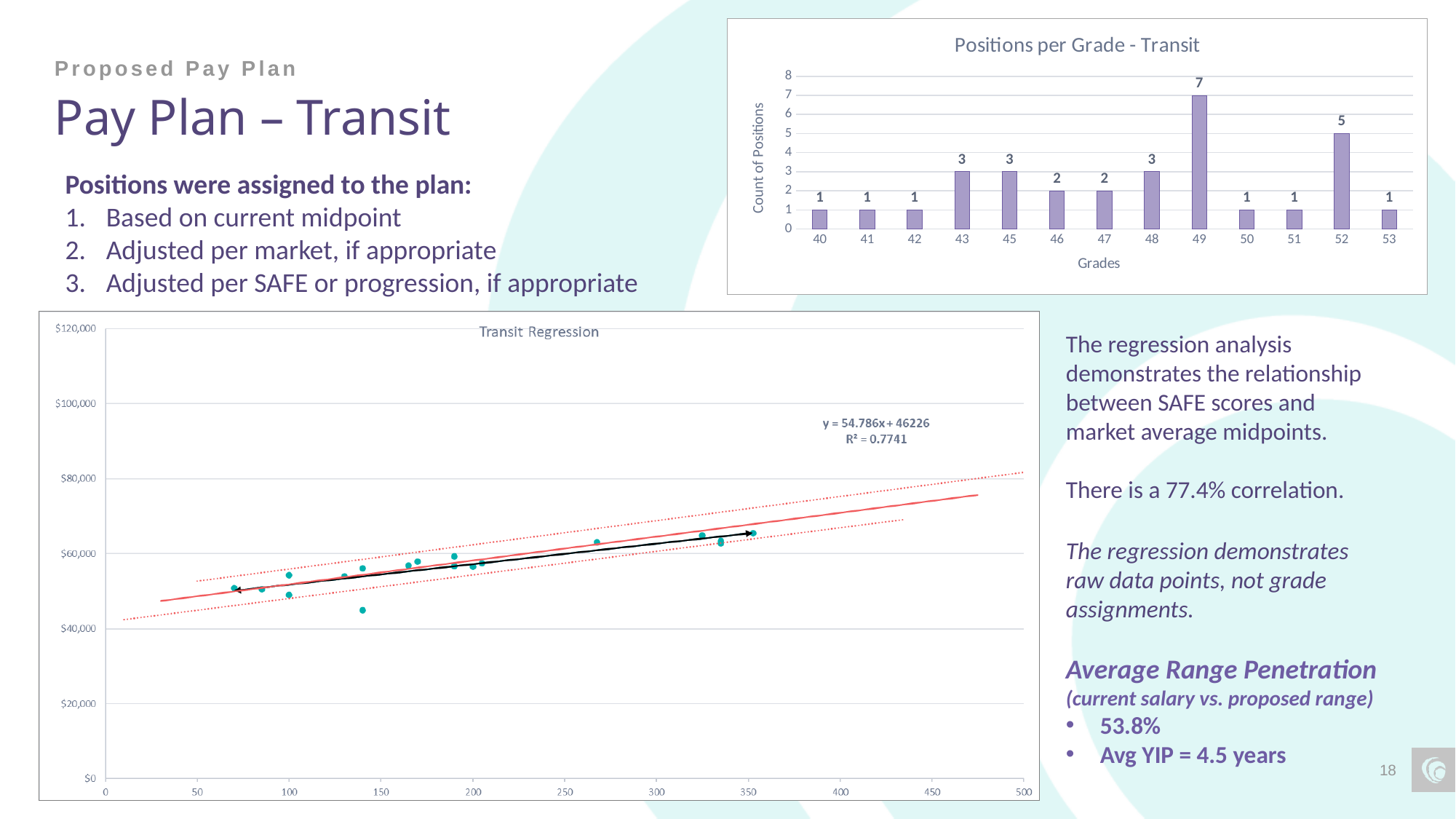
In the 'Positions per Grade - Transit' chart, how many positions are in grade 52? 5 What kind of chart is 'Positions per Grade - Transit'? Bar chart In the 'Positions per Grade - Transit' chart, which grade has the highest count of positions? 49 In the 'Positions per Grade - Transit' chart, how many positions are in grade 49? 7 In the 'Positions per Grade - Transit' chart, what is the label of the y axis? Count of Positions In the 'Transit Regression' chart, what R² value is shown? R² = 0.7741 In the 'Positions per Grade - Transit' chart, which has more positions, grade 43 or grade 47? Grade 43 In the 'Positions per Grade - Transit' chart, how many positions are in grade 46? 2 In the 'Positions per Grade - Transit' chart, how many grades have exactly 1 position? 6 In the 'Positions per Grade - Transit' chart, how many grades are shown on the x axis? 13 What kind of chart is 'Transit Regression'? Scatter chart In the 'Positions per Grade - Transit' chart, what is the difference between the count for grade 49 and the count for grade 52? 2